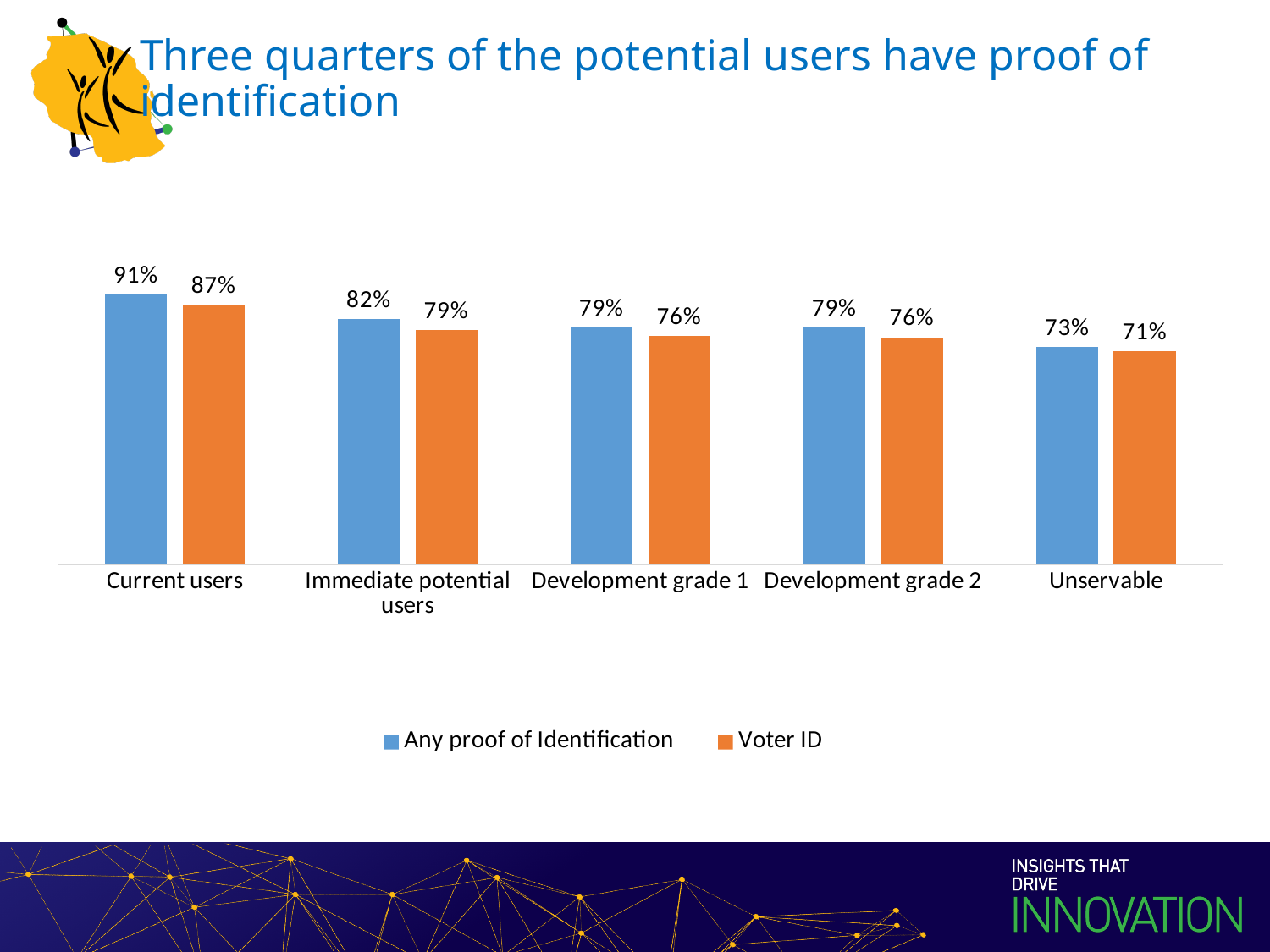
How many series does the legend list? 2 What is the difference between the Any proof of Identification values for Current users and Unservable? 18% What is the value for Any proof of Identification among Current users? 91% What is the Voter ID value for Immediate potential users? 79% How many categories are shown on the x axis? 5 What is the difference between Any proof of Identification and Voter ID for Current users? 4% Which category has the lowest Voter ID value? Unservable Which category has the highest value for Any proof of Identification? Current users What is the Voter ID value for Unservable? 71% What kind of chart is shown on the slide? Bar chart Which is larger for Development grade 1: Any proof of Identification or Voter ID? Any proof of Identification Which colour represents the Voter ID series? Orange